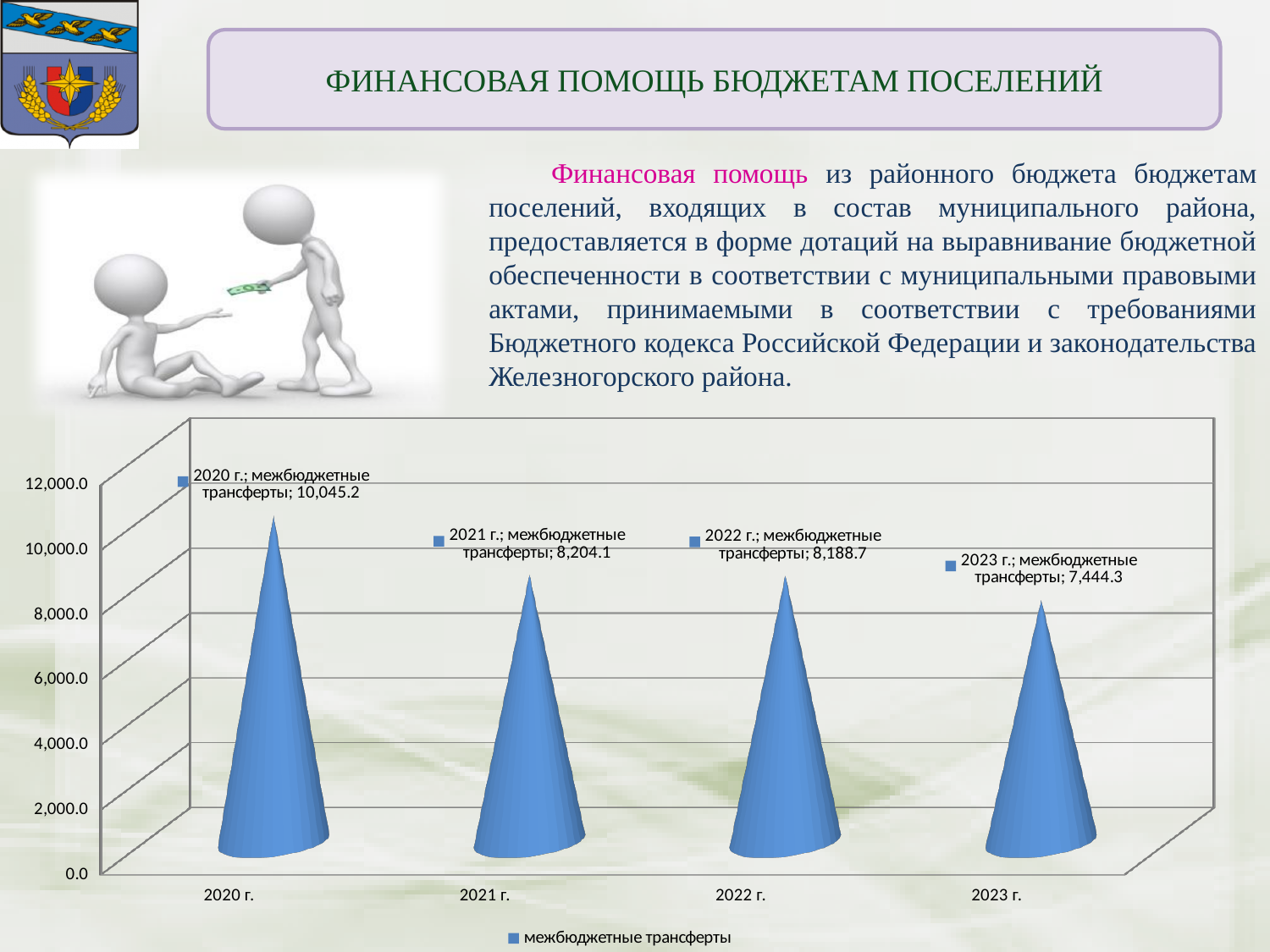
How many years are shown on the x axis of the chart? 4 What is the value of межбюджетные трансферты for 2022 г.? 8,188.7 Which is larger, the value for 2020 г. or the value for 2023 г.? 2020 г. How many series does the chart legend list? 1 What is the value of межбюджетные трансферты for 2020 г.? 10,045.2 Which year has the highest value of межбюджетные трансферты? 2020 г. What is the value of межбюджетные трансферты for 2023 г.? 7,444.3 What is the value of межбюджетные трансферты for 2021 г.? 8,204.1 Do the values rise or fall from 2020 г. to 2023 г.? fall What is the difference between the values for 2020 г. and 2021 г.? 1,841.1 What is the difference between the values for 2020 г. and 2023 г.? 2,600.9 Which year has the lowest value of межбюджетные трансферты? 2023 г.